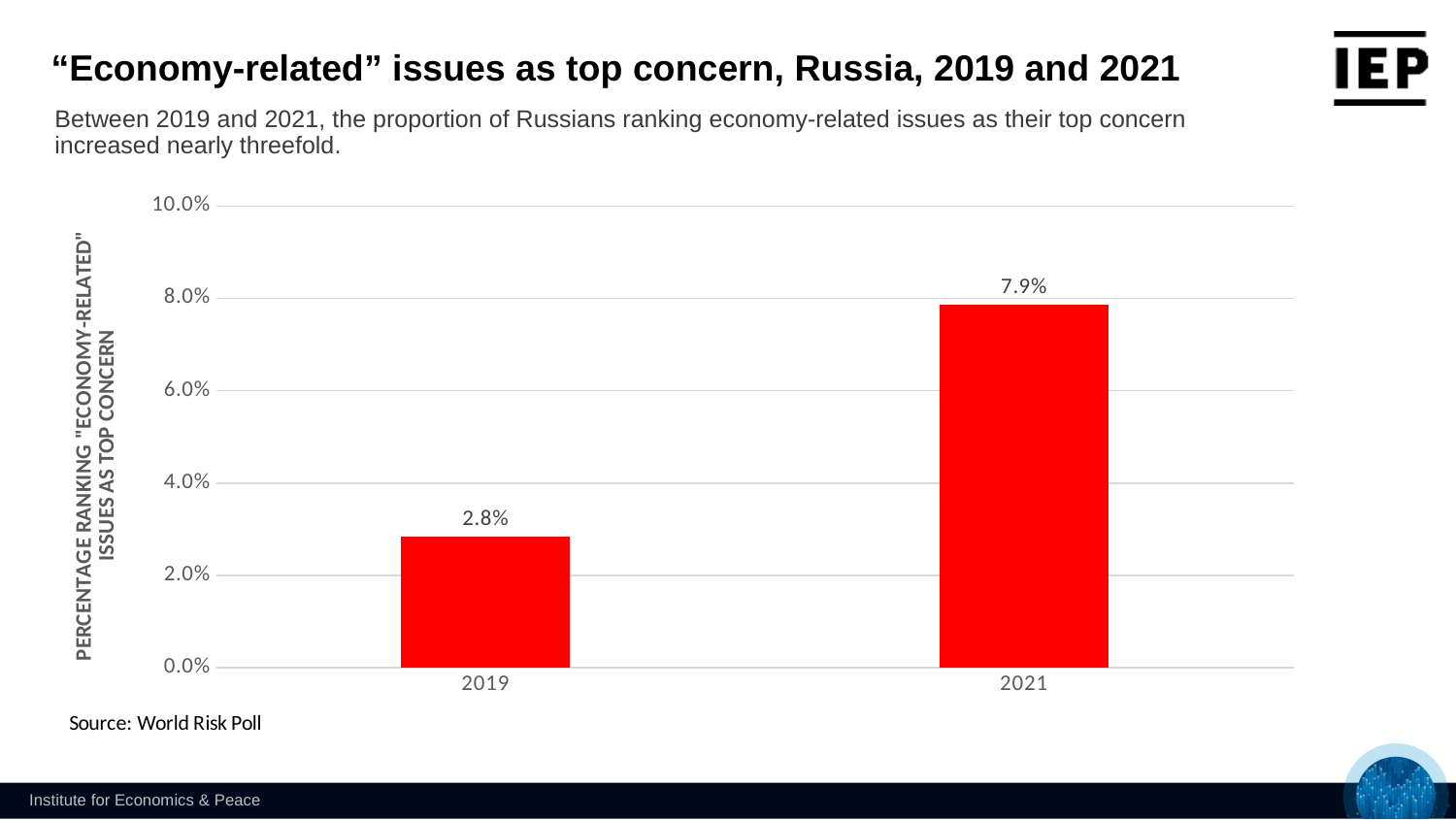
Is the value for 2019 greater or less than 4.0%? less Which year has the lower percentage ranking economy-related issues as top concern? 2019 What percentage of Russians ranked economy-related issues as their top concern in 2021? 7.9% By how many percentage points did the share ranking economy-related issues as top concern increase from 2019 to 2021? 5.1 percentage points Is the value for 2019 larger or smaller than the value for 2021? smaller How many years are shown on the chart? 2 Is the value for 2021 greater or less than 6.0%? greater What percentage of Russians ranked economy-related issues as their top concern in 2019? 2.8% Do the values rise or fall from 2019 to 2021? Rise What is the source cited for the chart data? World Risk Poll What kind of chart is shown on the slide? Bar chart Which year has the higher percentage ranking economy-related issues as top concern? 2021